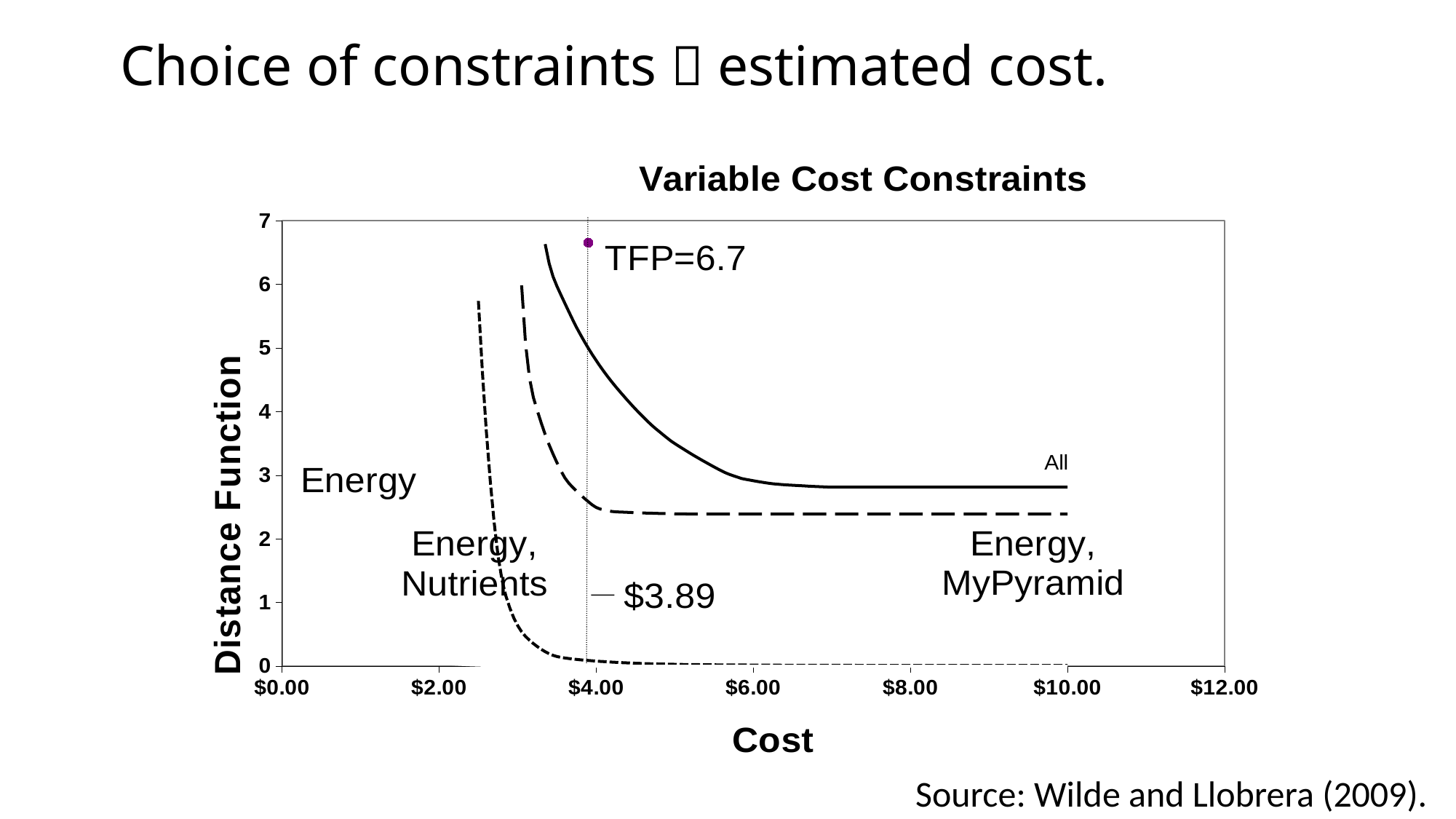
What is the label of the vertical axis of the chart? Distance Function At what cost is the TFP point located, according to the label on the chart? $3.89 Which curve has the highest distance function value at a cost of $8.00? All What kind of chart is shown on the slide? line chart Is the value of the Energy curve at a cost of $8.00 greater or less than 1? less At a cost of $8.00, which curve is higher: All or Energy, MyPyramid? All What is the distance function value of the TFP point marked on the chart? 6.7 What is the title of the chart? Variable Cost Constraints Is the value of the Energy, MyPyramid curve at a cost of $8.00 greater or less than 2? greater Does the All curve rise or fall as cost increases from $4.00 to $6.00? fall